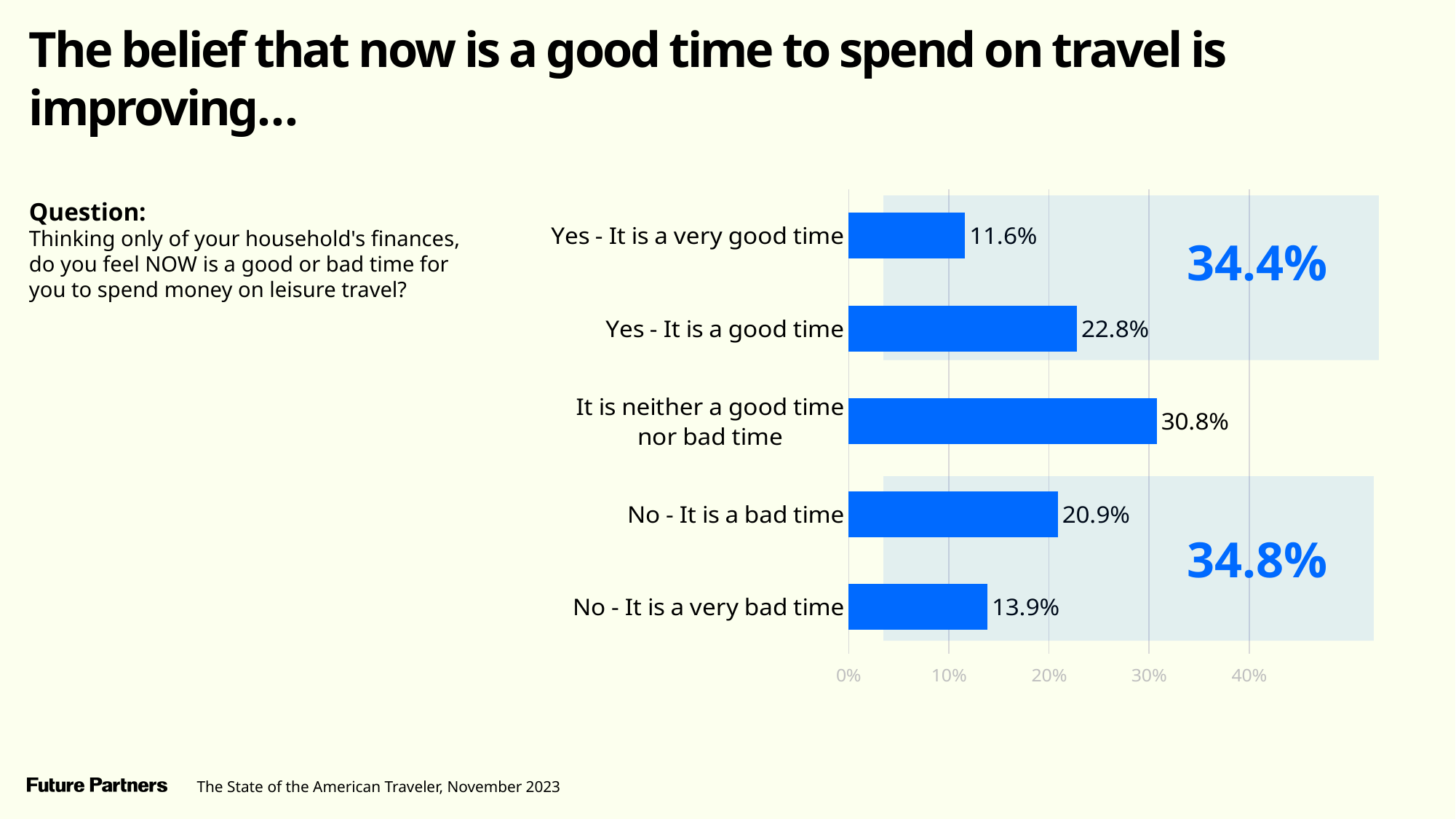
What percentage of respondents said 'Yes - It is a very good time'? 11.6% Which is larger: 'No - It is a very bad time' or 'Yes - It is a very good time'? No - It is a very bad time How many response categories are shown in the chart? 5 What percentage of respondents said 'It is neither a good time nor bad time'? 30.8% What combined percentage is shown for the two 'No' responses? 34.8% What combined percentage is shown for the two 'Yes' responses? 34.4% Which response category has the lowest percentage? Yes - It is a very good time What is the difference between 'Yes - It is a good time' and 'No - It is a bad time'? 1.9% Is the value for 'It is neither a good time nor bad time' greater or less than 40%? less What kind of chart is shown on the slide? Bar chart Which response category has the highest percentage? It is neither a good time nor bad time What percentage of respondents said 'No - It is a very bad time'? 13.9%